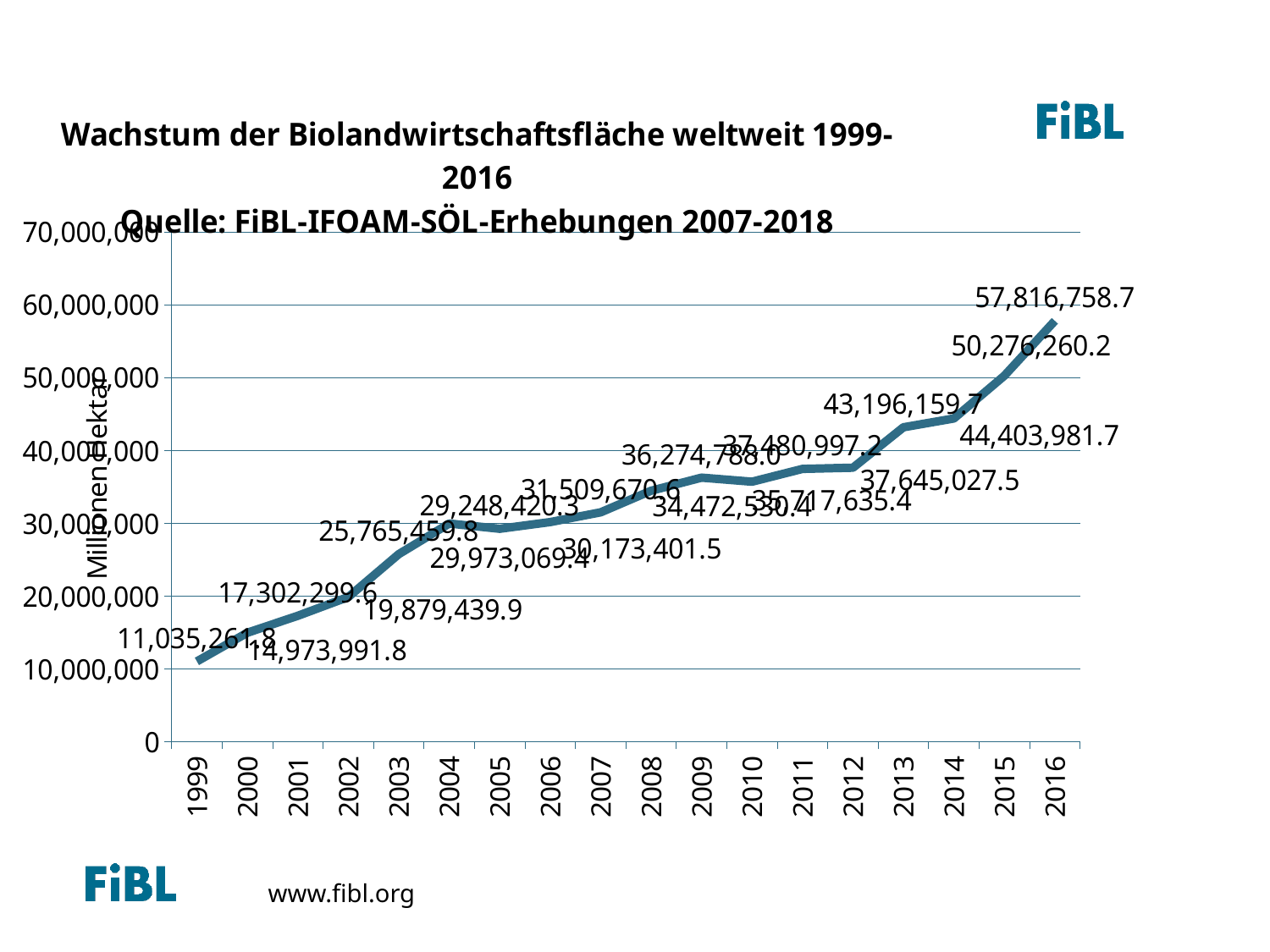
What is the value for 2003? 25,765,459.8 Which is larger, the value for 2004 or the value for 2005? 2004 Do the values generally rise or fall from 1999 to 2016? Rise What is the value for 1999? 11,035,261.8 Which year has the highest value? 2016 What type of chart is shown on the slide? Line chart What is the value for 2016? 57,816,758.7 Is the value for 2010 greater or less than 30,000,000? greater How many years are plotted on the x axis? 18 What is the difference between the values for 2016 and 2015? 7,540,498.5 What is the value for 2013? 43,196,159.7 Which year has the lowest value? 1999